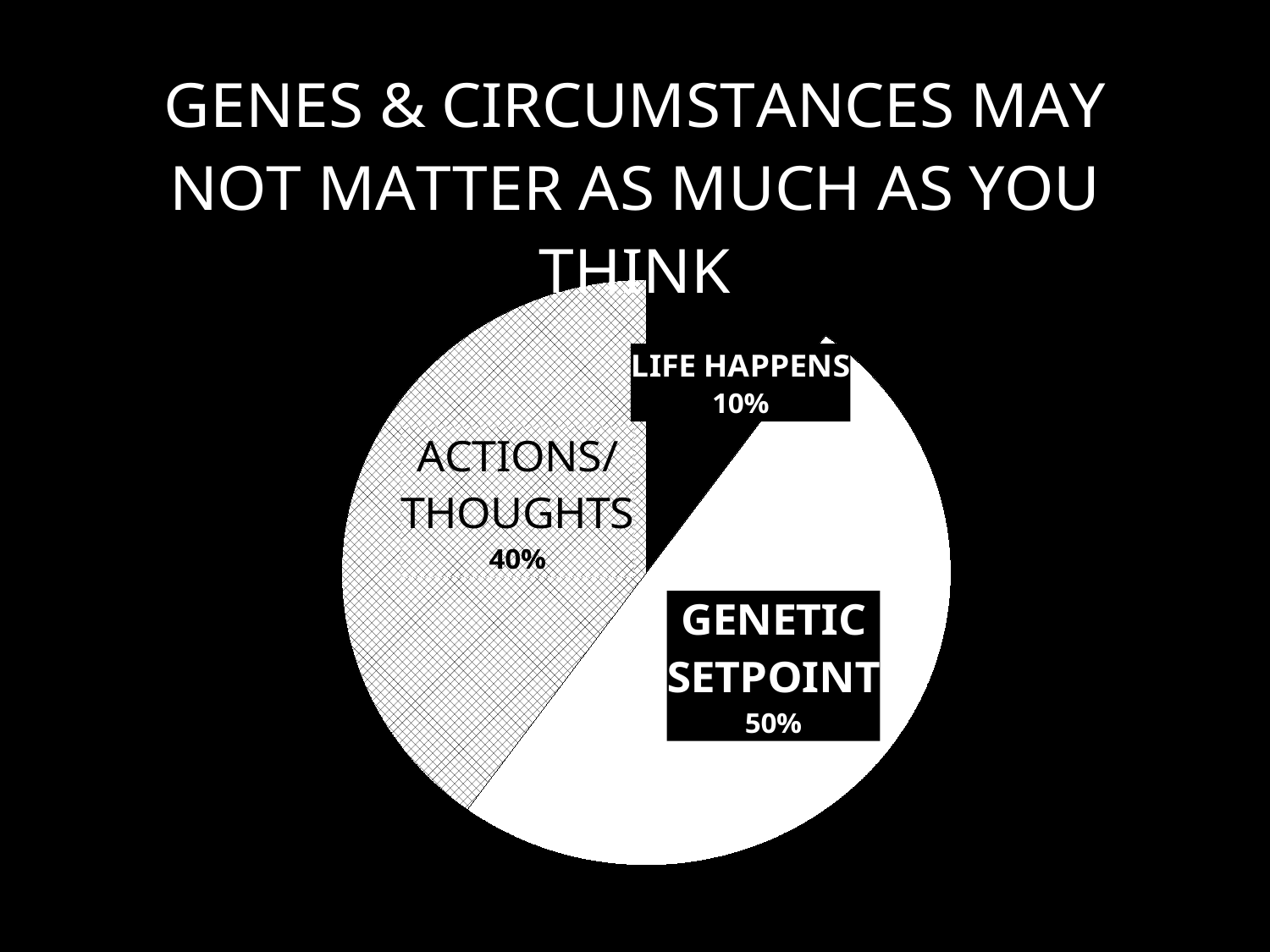
What kind of chart is shown on the slide? pie chart Which slice of the pie is the largest? GENETIC SETPOINT What percentage is shown for ACTIONS/THOUGHTS? 40% How many slices does the pie chart have? 3 What percentage is shown for LIFE HAPPENS? 10% What is the difference in percentage points between GENETIC SETPOINT and ACTIONS/THOUGHTS? 10 What is the difference in percentage points between ACTIONS/THOUGHTS and LIFE HAPPENS? 30 What percentage is shown for GENETIC SETPOINT? 50% What share of the pie does the GENETIC SETPOINT slice represent? 50% What is the title of the slide containing the pie chart? GENES & CIRCUMSTANCES MAY NOT MATTER AS MUCH AS YOU THINK Which slice of the pie is the smallest? LIFE HAPPENS Which is larger, the ACTIONS/THOUGHTS slice or the LIFE HAPPENS slice? ACTIONS/THOUGHTS